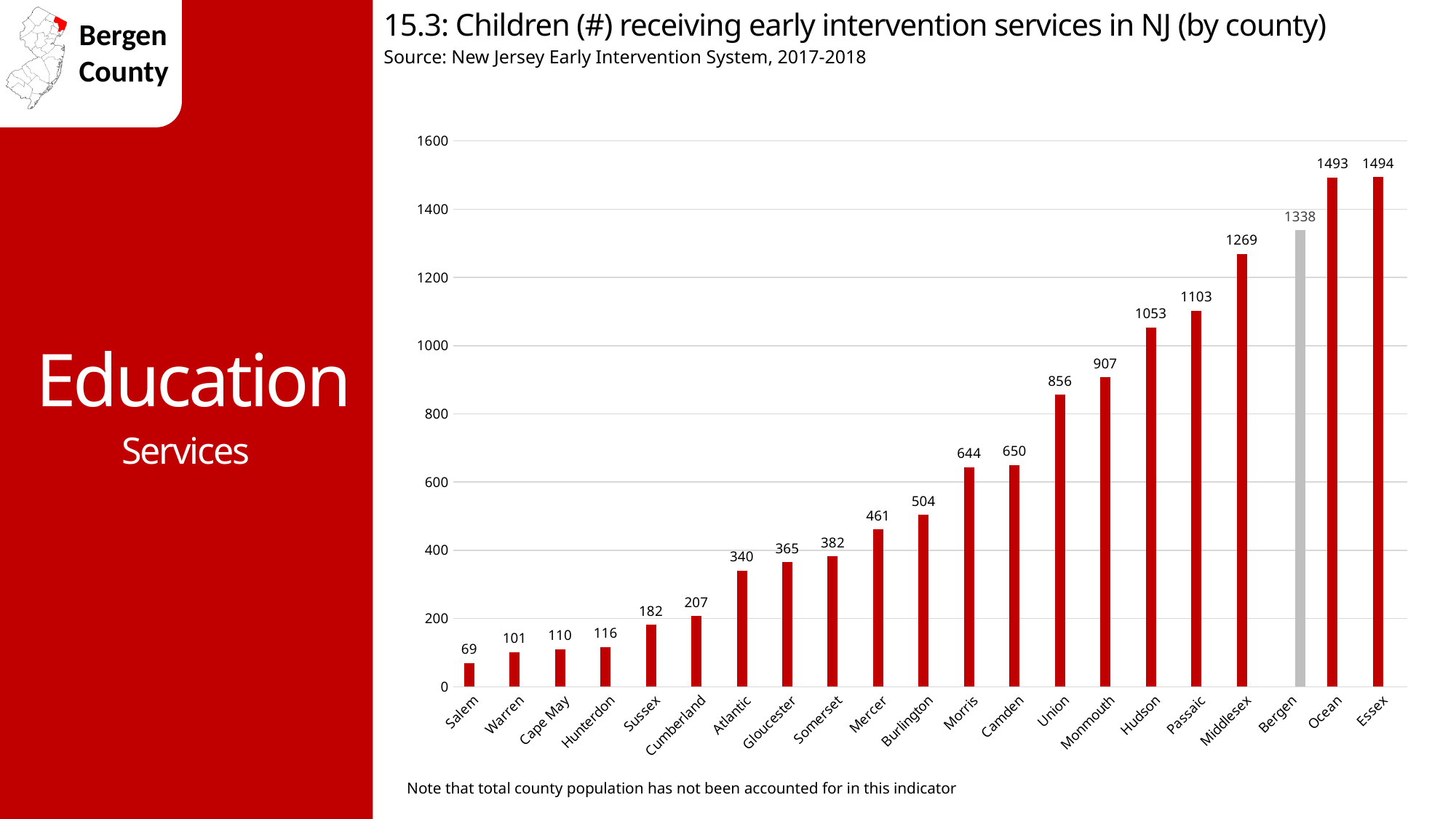
What is the difference between the values for Bergen and Middlesex? 69 What is the difference between the values for Hudson and Union? 197 Which is larger, the value for Passaic or the value for Monmouth? Passaic How many children received early intervention services in Bergen County? 1338 Which county's bar is coloured grey instead of red? Bergen What type of chart is shown on the slide? bar chart What is the value for Hudson? 1053 Do the values generally rise or fall moving from left to right along the x axis? rise How many counties are shown on the x axis? 21 What is the value for Cape May? 110 Which county has the lowest number of children receiving early intervention services? Salem Is the value for Camden greater or less than 600? greater